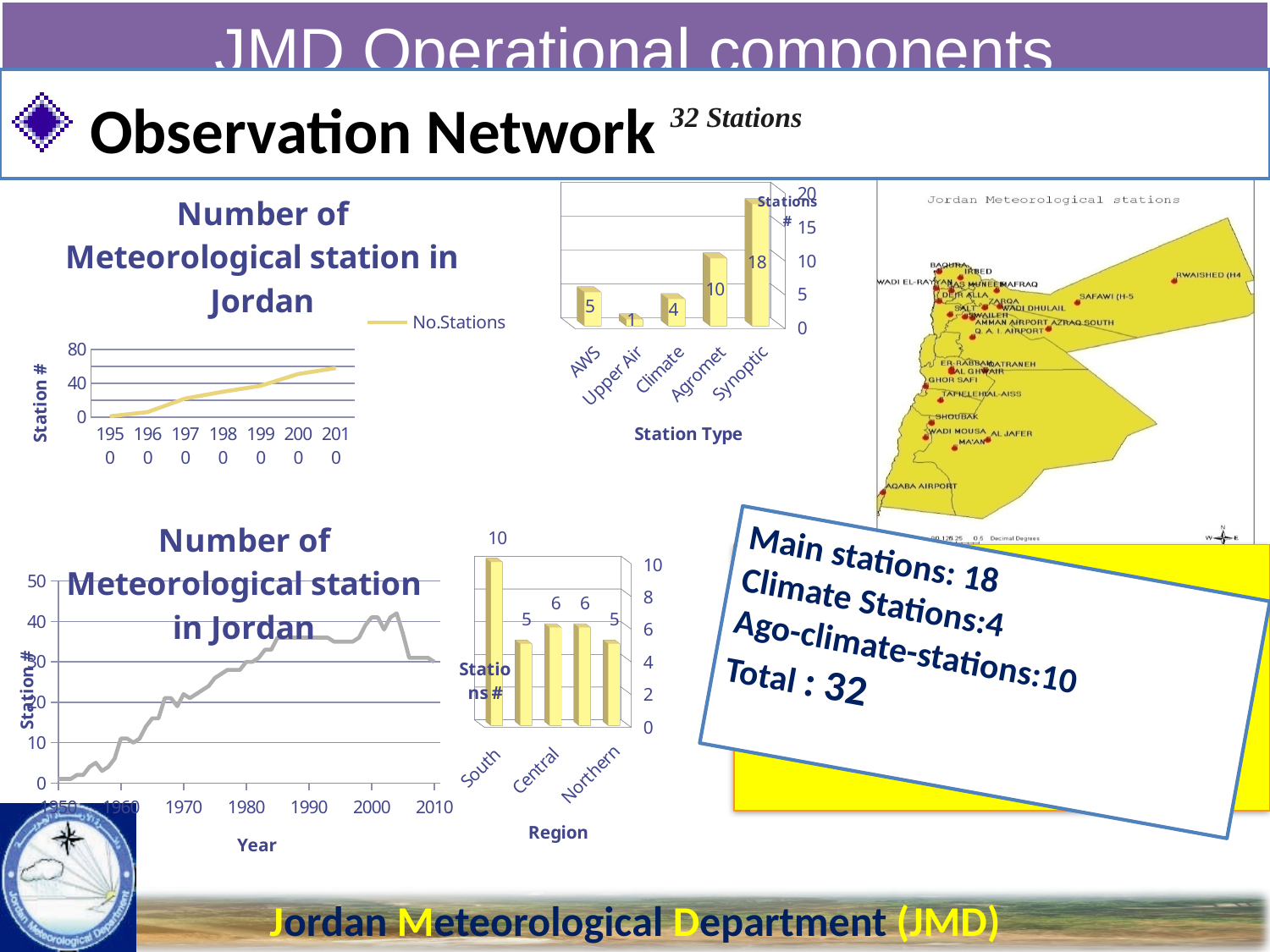
In the Station Type bar chart, which station type has the highest number of stations? Synoptic In the Station Type bar chart, what is the value for Synoptic? 18 In the bottom-left line chart 'Number of Meteorological station in Jordan', do the values generally rise or fall from 1950 to 2010? rise In the Station Type bar chart, what is the value for Upper Air? 1 In the Region bar chart at the bottom of the slide, what is the highest value shown? 10 In the Station Type bar chart, which station type has the lowest number of stations? Upper Air What kind of chart is the Station Type chart? bar chart In the Station Type bar chart, what is the value for Agromet? 10 In the Station Type bar chart, which is larger, the value for AWS or the value for Climate? AWS How many station types are shown in the Station Type bar chart? 5 In the Station Type bar chart, what is the difference between the Synoptic and Agromet values? 8